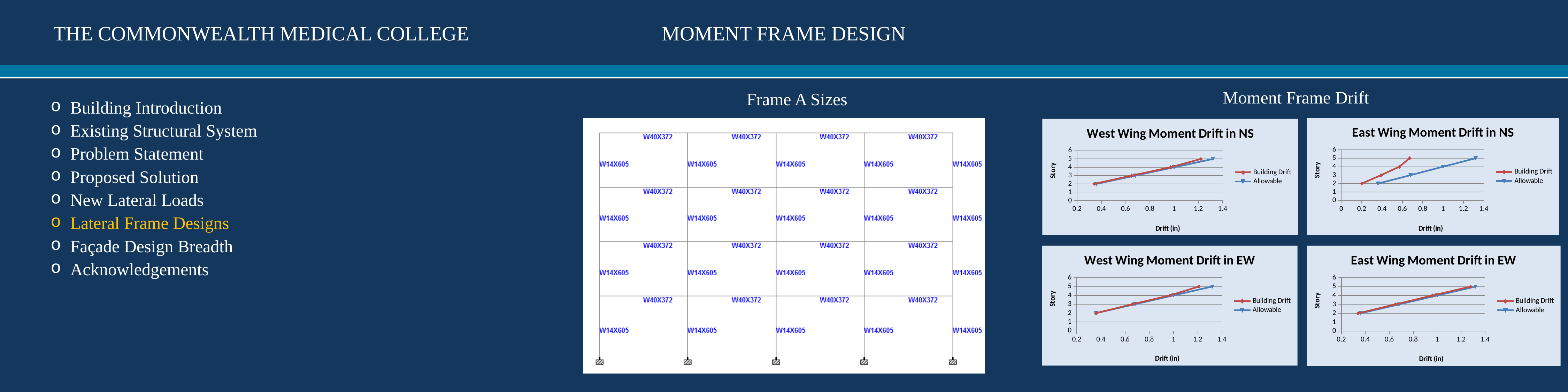
In the "East Wing Moment Drift in NS" chart, is the Drift (in) value of the Building Drift series at Story 5 greater or less than 1? less How many moment drift charts are shown under the heading "Moment Frame Drift"? 4 How many data points does the Building Drift series have in the "West Wing Moment Drift in EW" chart? 4 In the "West Wing Moment Drift in NS" chart, is the Drift (in) value of the Building Drift series at Story 5 greater or less than 1? greater What is the x-axis title of the "East Wing Moment Drift in EW" chart? Drift (in) In the "East Wing Moment Drift in NS" chart, does the Story value rise or fall as Drift (in) increases along the x axis? rise In the "West Wing Moment Drift in EW" chart, is the Drift (in) value of the Building Drift series at Story 2 greater or less than 0.6? less What kind of chart is the "West Wing Moment Drift in NS" chart? line chart How many series does the legend of the "East Wing Moment Drift in NS" chart list? 2 What are the two series named in the legend of the "West Wing Moment Drift in EW" chart? Building Drift and Allowable In the "East Wing Moment Drift in NS" chart, which series reaches Story 5 at a larger Drift (in) value, Building Drift or Allowable? Allowable